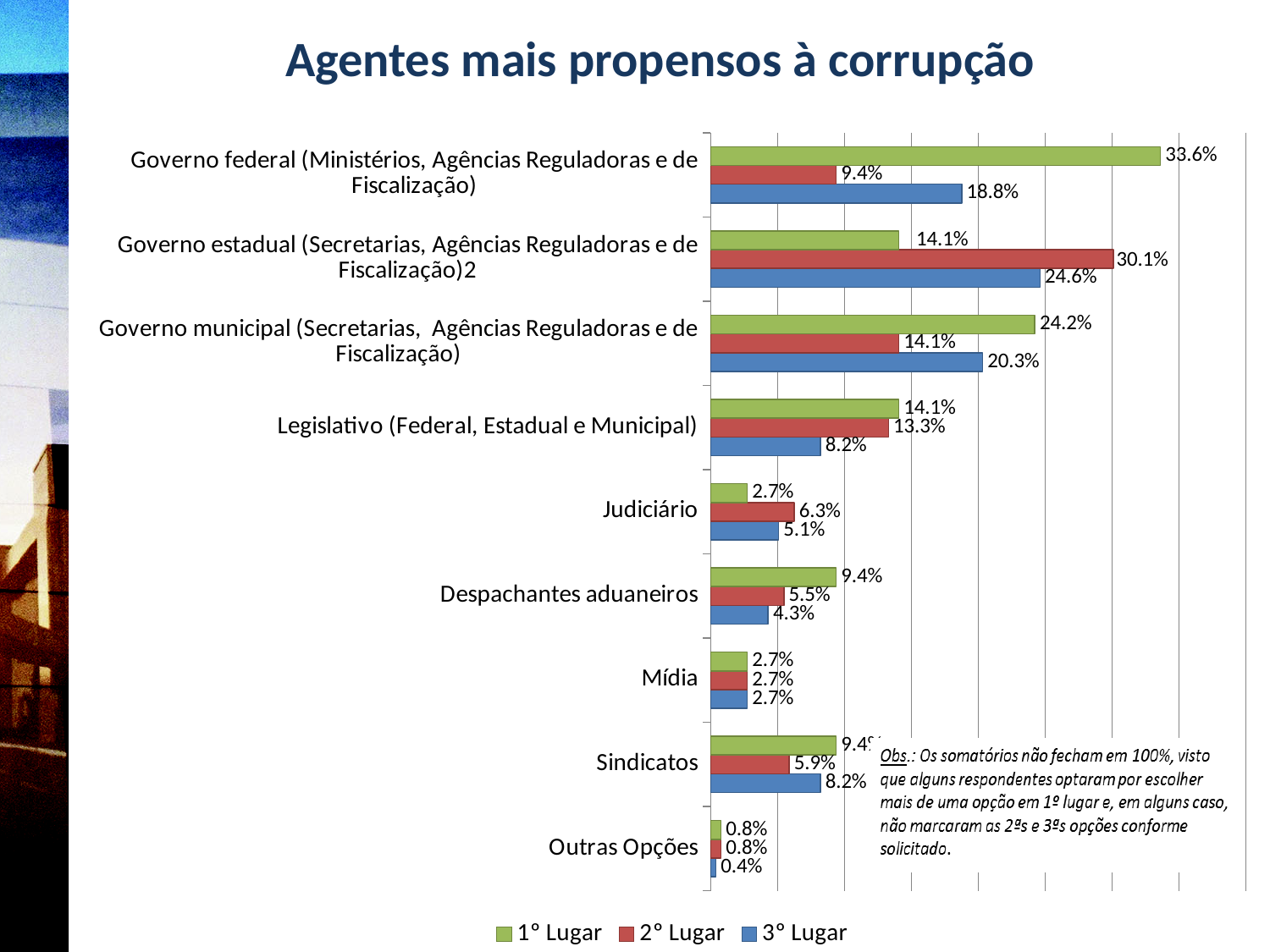
What is the 2° Lugar value for Judiciário? 6.3% What is the 1° Lugar value for Governo federal (Ministérios, Agências Reguladoras e de Fiscalização)? 33.6% What colour represents the 3° Lugar series in the legend? Blue How many series does the legend list? 3 What kind of chart is shown on the slide? Bar chart Which category has the highest 1° Lugar value? Governo federal (Ministérios, Agências Reguladoras e de Fiscalização) Which is larger for Legislativo (Federal, Estadual e Municipal): the 1° Lugar value or the 3° Lugar value? 1° Lugar Which category has the lowest 3° Lugar value? Outras Opções What is the 2° Lugar value for Governo estadual (Secretarias, Agências Reguladoras e de Fiscalização)2? 30.1% What is the 3° Lugar value for Governo municipal (Secretarias, Agências Reguladoras e de Fiscalização)? 20.3% What is the difference between the 1° Lugar and 2° Lugar values for Governo federal (Ministérios, Agências Reguladoras e de Fiscalização)? 24.2% How many categories are shown on the chart? 9